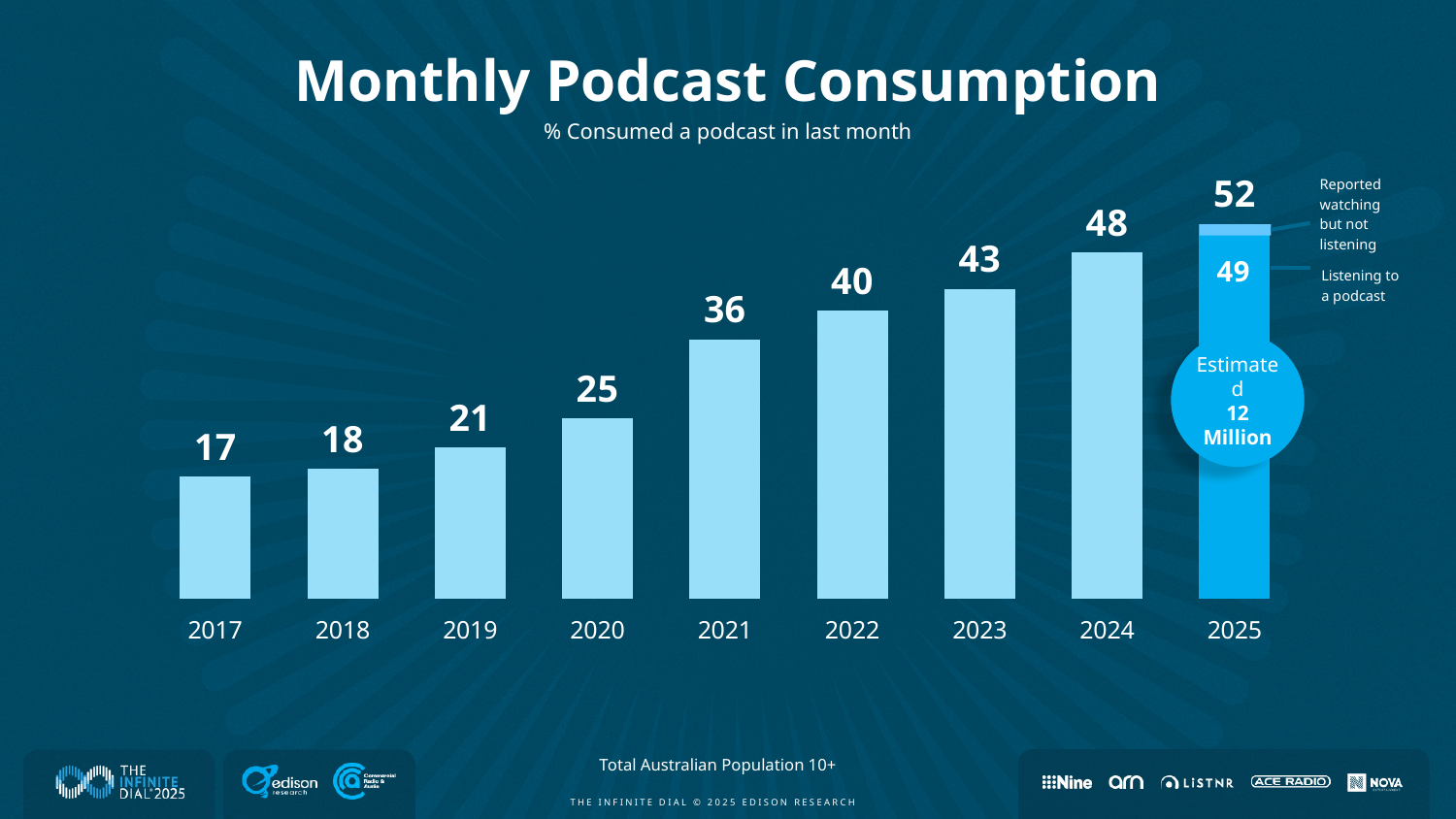
What is the difference between the values for 2024 and 2023? 5 What is the value for 2024? 48 Which year has the highest value? 2025 What kind of chart is this? bar chart Do the values rise or fall from 2017 to 2025? rise What is the total of the stacked bar for 2025? 52 What is the value for 2021? 36 What is the value for 2017? 17 Which is larger, the value for 2019 or the value for 2020? 2020 How many years are shown on the x axis? 9 Which year has the lowest value? 2017 In 2025, what is the value for 'Listening to a podcast'? 49